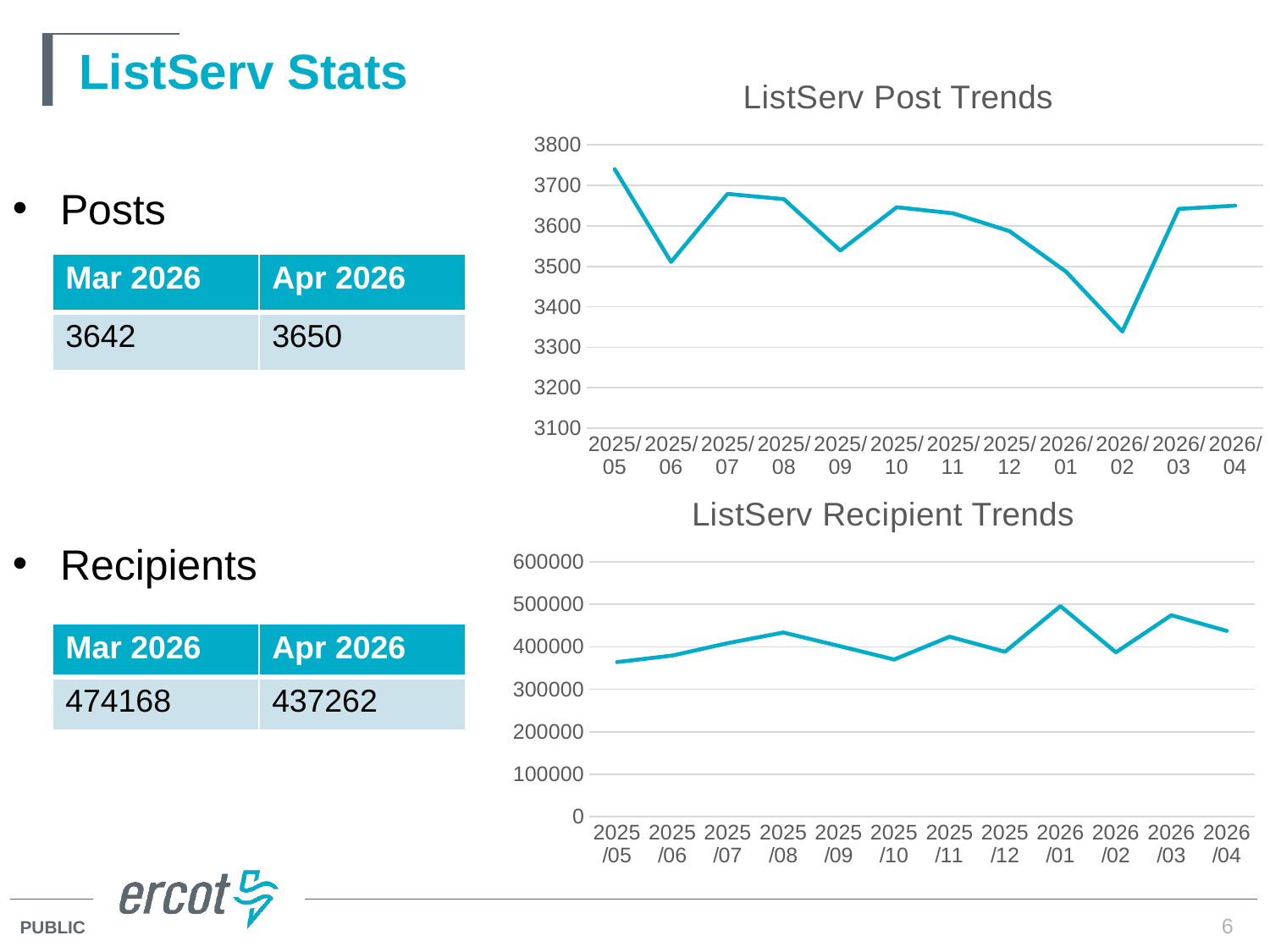
How many monthly data points are plotted on the ListServ Post Trends chart? 12 What kind of chart is the ListServ Post Trends chart? line chart On the ListServ Recipient Trends chart, is the value for 2025/05 greater or less than 400000? less On the ListServ Post Trends chart, which month has the highest value? 2025/05 On the ListServ Post Trends chart, which is larger, the value for 2025/07 or the value for 2025/09? 2025/07 On the ListServ Post Trends chart, is the value for 2026/02 greater or less than 3400? less On the ListServ Post Trends chart, is the value for 2025/05 greater or less than 3700? greater On the ListServ Recipient Trends chart, which month has the highest value? 2026/01 According to the Recipients table, what is the difference between the Mar 2026 and Apr 2026 values on the ListServ Recipient Trends chart? 36906 On the ListServ Post Trends chart, which month has the lowest value? 2026/02 According to the Posts table, what is the value for Apr 2026 shown on the ListServ Post Trends chart? 3650 On the ListServ Post Trends chart, do the values rise or fall from 2026/02 to 2026/04? rise